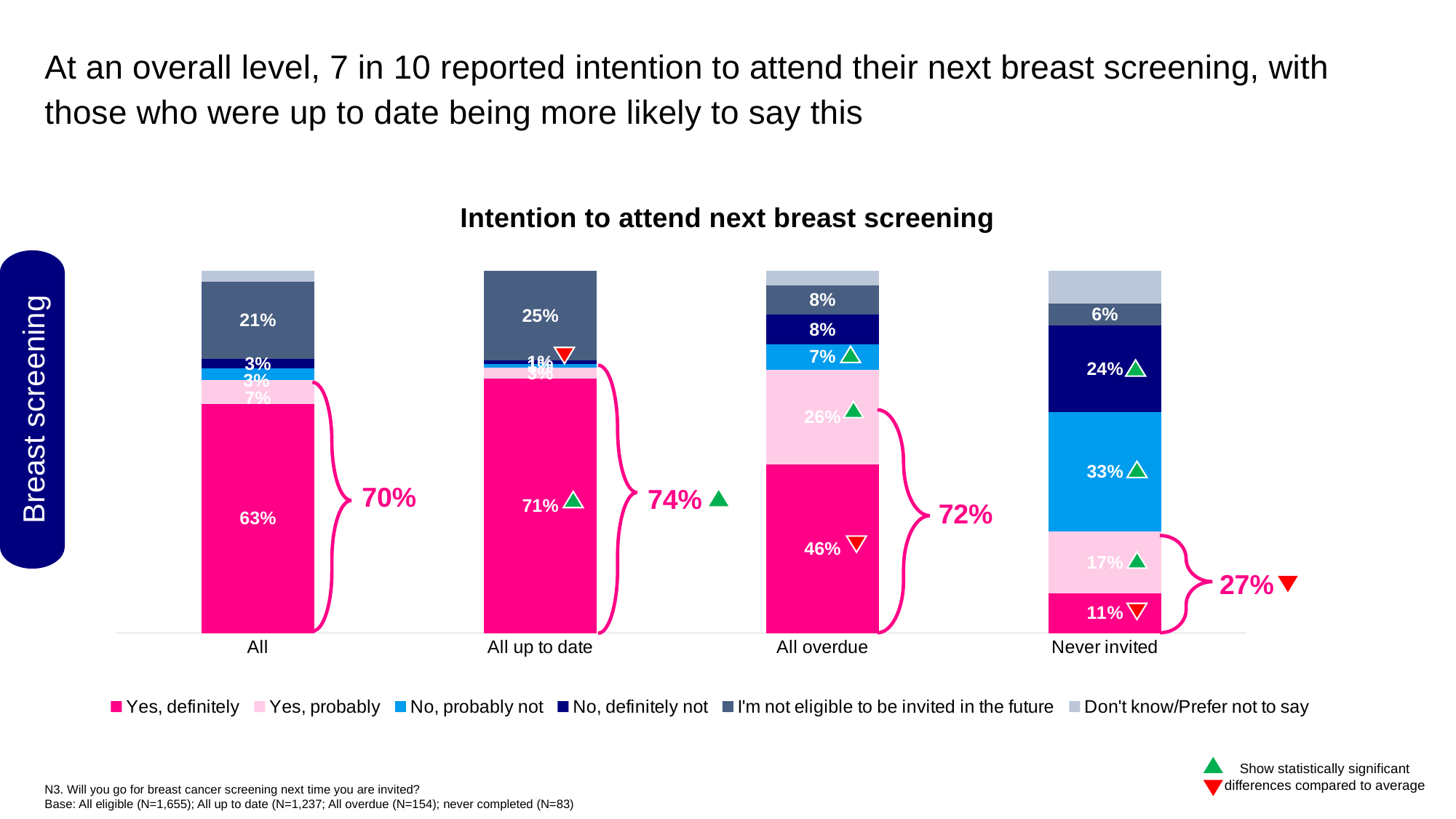
What is the 'Yes, definitely' value for the 'All' category? 63% Which category has the lowest 'Yes, definitely' value? Never invited How many series does the legend list? 6 How many categories are shown along the x axis of the chart? 4 What is the difference between the 'Yes, definitely' values for 'All up to date' and 'All overdue'? 25 percentage points Which category has the larger 'No, definitely not' value: 'All overdue' or 'Never invited'? Never invited What is the 'No, probably not' value for the 'Never invited' category? 33% What is the 'Yes, definitely' value for the 'All overdue' category? 46% What is the 'I'm not eligible to be invited in the future' value for the 'All up to date' category? 25% What kind of chart is shown on the slide? Stacked bar chart What combined 'Yes' percentage is shown by the bracket for the 'Never invited' category? 27% Which category has the highest 'Yes, definitely' value? All up to date